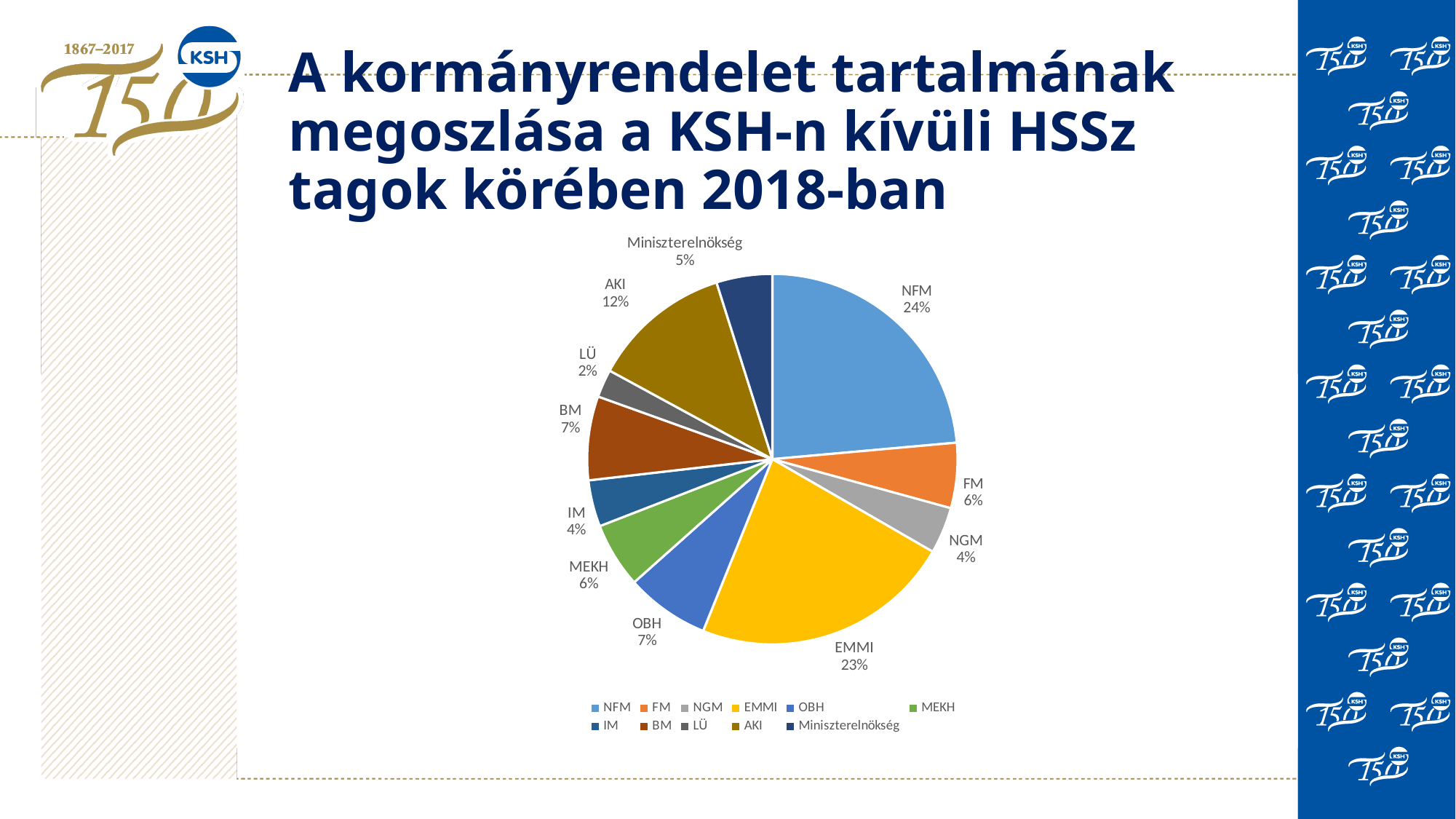
Which category has the largest slice of the pie? NFM What share of the pie does NFM have? 24% Which category has the smallest slice of the pie? LÜ What share of the pie does AKI have? 12% What share of the pie does EMMI have? 23% What is the difference in percentage points between AKI and BM? 5 What kind of chart is shown on the slide? pie chart What is the combined share of NFM and EMMI? 47% How many slices does the pie chart have? 11 Which is larger, the share for OBH or the share for IM? OBH What share of the pie does Miniszterelnökség have? 5% How many entries does the legend list? 11